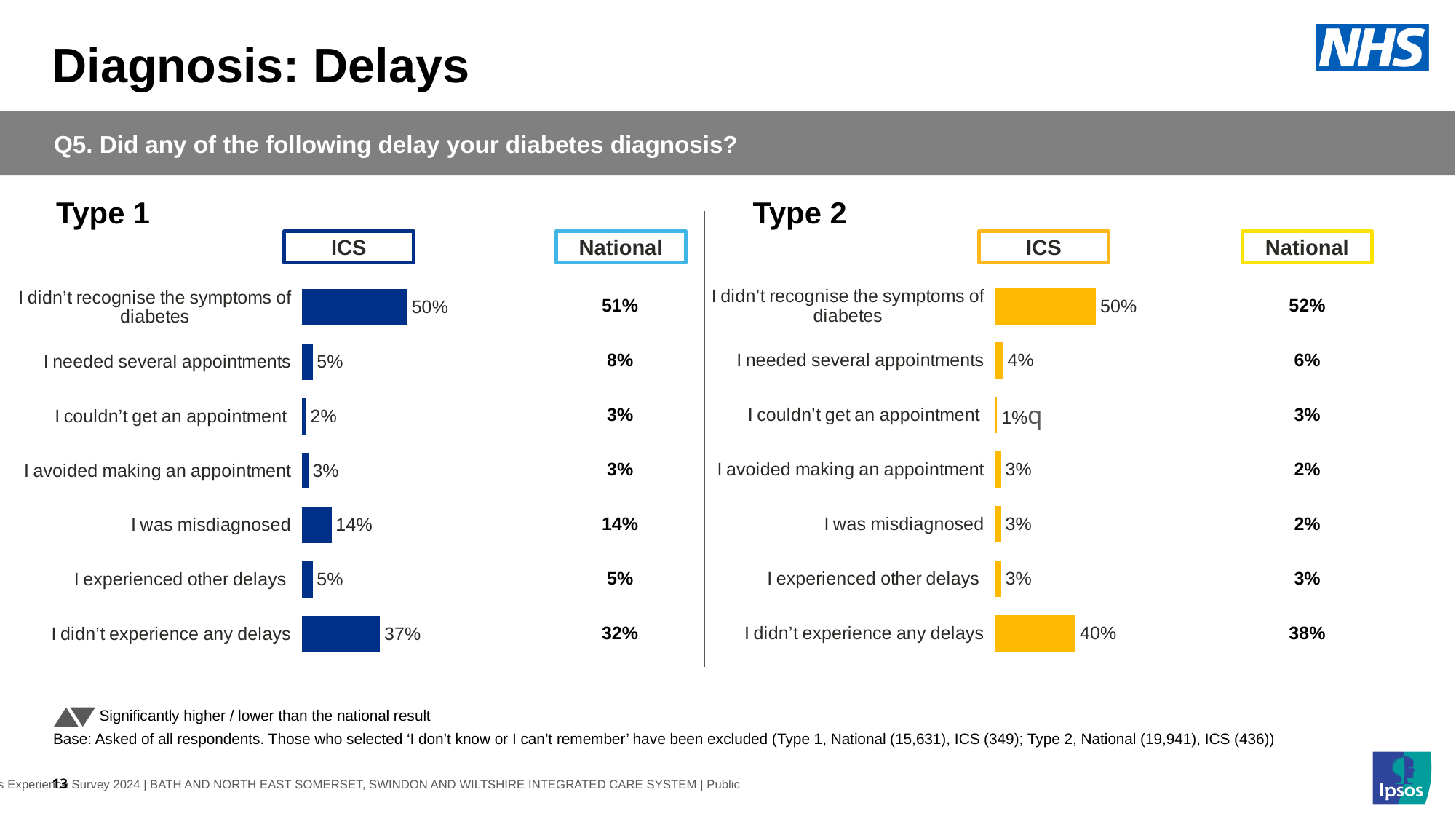
In the Type 1 chart, what is the difference between the ICS and National values for 'I didn't experience any delays'? 5% In the Type 1 chart, what is the National value for 'I needed several appointments'? 8% In the Type 2 chart, what is the ICS value for 'I didn't experience any delays'? 40% In the Type 2 chart, what is the National value for 'I didn't recognise the symptoms of diabetes'? 52% In the Type 1 chart, which is larger: the ICS value for 'I was misdiagnosed' or the ICS value for 'I needed several appointments'? I was misdiagnosed How many categories are shown in the Type 2 chart? 7 In the Type 1 chart, what is the ICS value for 'I didn't recognise the symptoms of diabetes'? 50% In the Type 1 chart, which category has the lowest ICS value? I couldn't get an appointment In the Type 2 chart, what is the difference between the ICS and National values for 'I needed several appointments'? 2% In the Type 2 chart, which category has the lowest ICS value? I couldn't get an appointment In the Type 1 chart, which category has the highest ICS value? I didn't recognise the symptoms of diabetes What type of chart is used for the ICS values in the Type 1 section? Bar chart